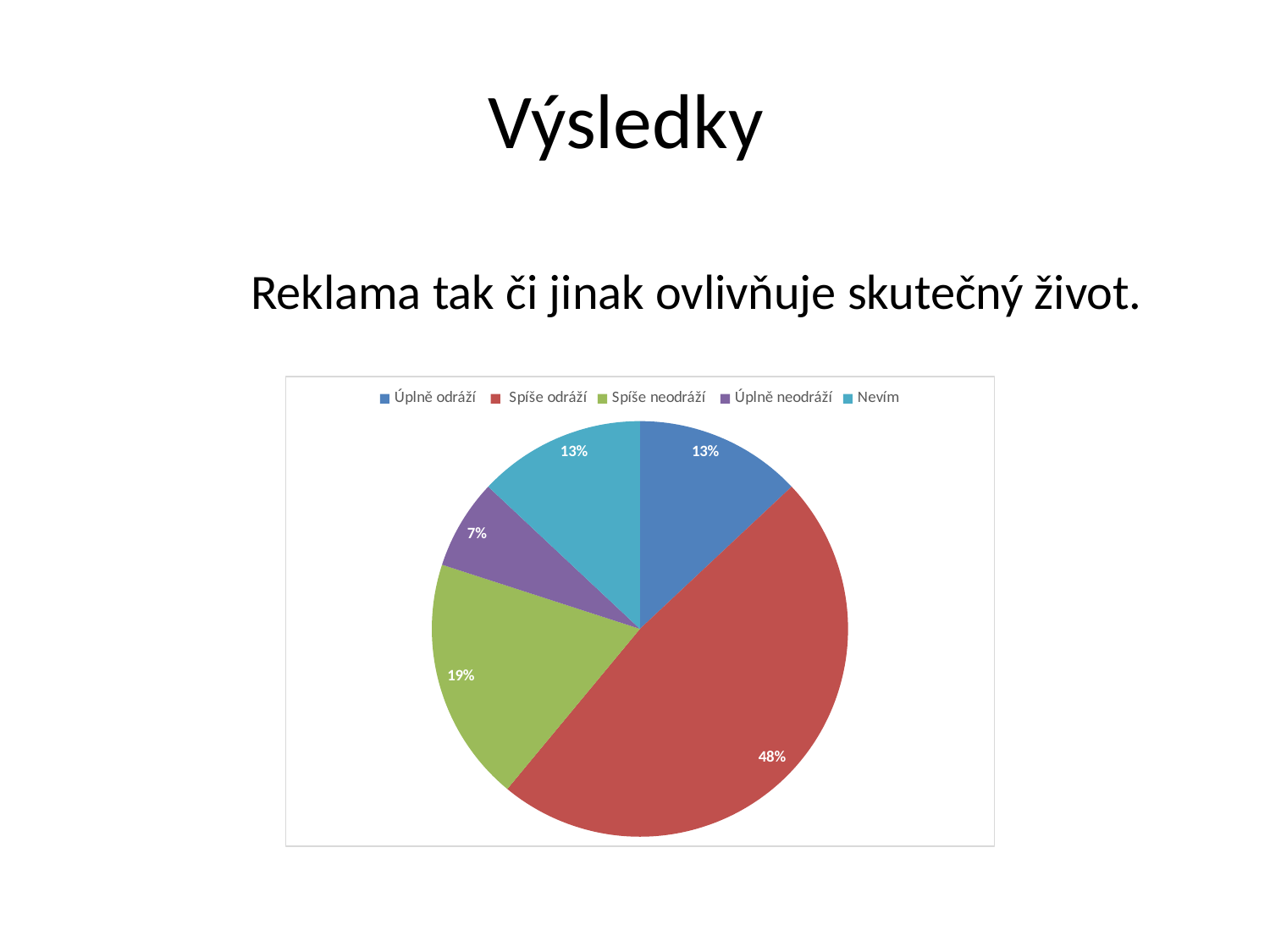
Which category has the smallest slice of the pie? Úplně neodráží How many categories does the legend list? 5 What share of the pie does "Úplně odráží" have? 13% What is the difference in percentage points between "Spíše odráží" and "Spíše neodráží"? 29 What colour is the slice for "Nevím"? light blue What kind of chart is shown on the slide? pie chart Which category has the largest slice of the pie? Spíše odráží What share of the pie does "Nevím" have? 13% What share of the pie does "Úplně neodráží" have? 7% Which is larger, the slice for "Spíše neodráží" or the slice for "Úplně neodráží"? Spíše neodráží